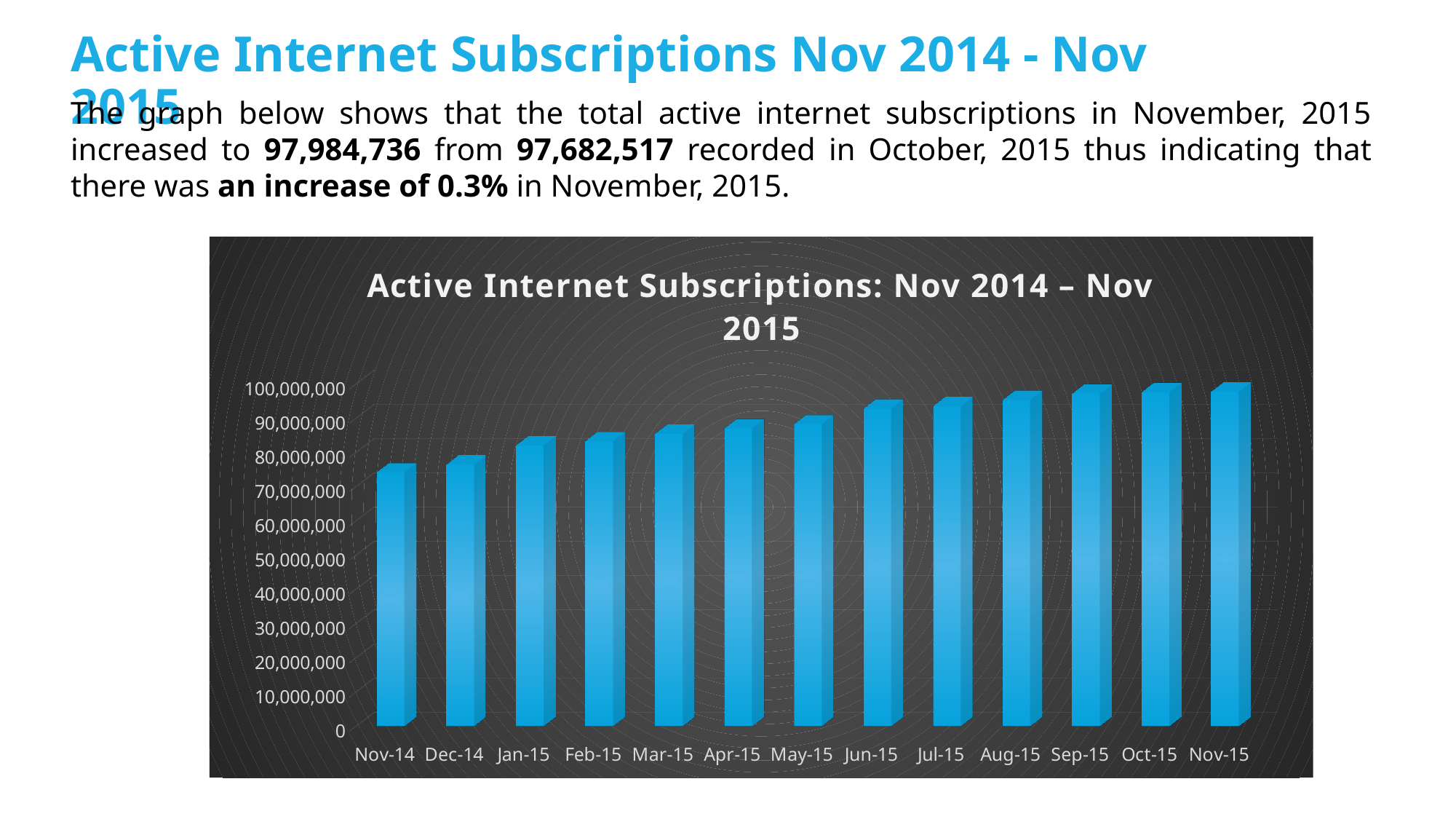
What kind of chart is shown on the slide? bar chart Is the value for Jun-15 greater or less than 90,000,000? greater Is the value for Nov-14 greater or less than 70,000,000? greater Which is larger, the value for Dec-14 or the value for Jun-15? Jun-15 Is the value for Jan-15 greater or less than 80,000,000? greater Which is larger, the value for Nov-14 or the value for Nov-15? Nov-15 How many months are plotted on the x axis of the chart? 13 What is the title of the chart? Active Internet Subscriptions: Nov 2014 – Nov 2015 Do active internet subscriptions generally rise or fall from Nov-14 to Nov-15? rise Which month has the lowest number of active internet subscriptions in the chart? Nov-14